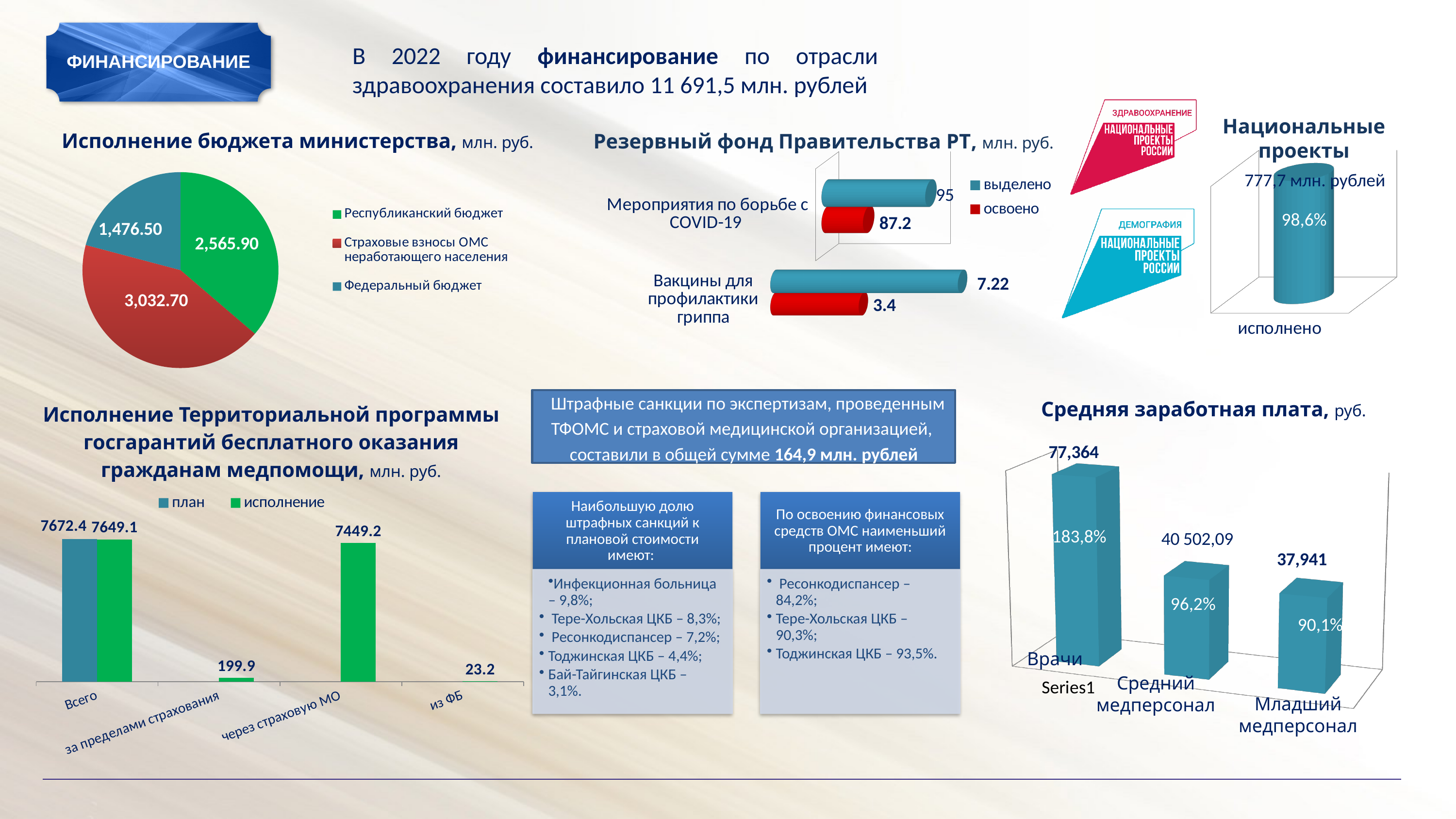
In the chart 'Средняя заработная плата', which category has the highest value? Врачи In the chart 'Национальные проекты', what percentage is shown for 'исполнено'? 98,6% In the chart 'Резервный фонд Правительства РТ', what is the 'освоено' value for Мероприятия по борьбе с COVID-19? 87.2 In the chart 'Средняя заработная плата', what is the value for Младший медперсонал? 37,941 In the chart 'Исполнение Территориальной программы госгарантий', what is the 'план' value for Всего? 7672.4 In the pie chart 'Исполнение бюджета министерства', what is the value for Федеральный бюджет? 1,476.50 In the pie chart 'Исполнение бюджета министерства', how many categories does the legend list? 3 What kind of chart is 'Резервный фонд Правительства РТ'? bar chart In the chart 'Резервный фонд Правительства РТ', what is the 'выделено' value for Вакцины для профилактики гриппа? 7.22 In the chart 'Резервный фонд Правительства РТ', how many series does the legend list? 2 In the pie chart 'Исполнение бюджета министерства', what is the difference between Страховые взносы ОМС неработающего населения and Республиканский бюджет? 466.80 In the pie chart 'Исполнение бюджета министерства', which category has the largest value? Страховые взносы ОМС неработающего населения